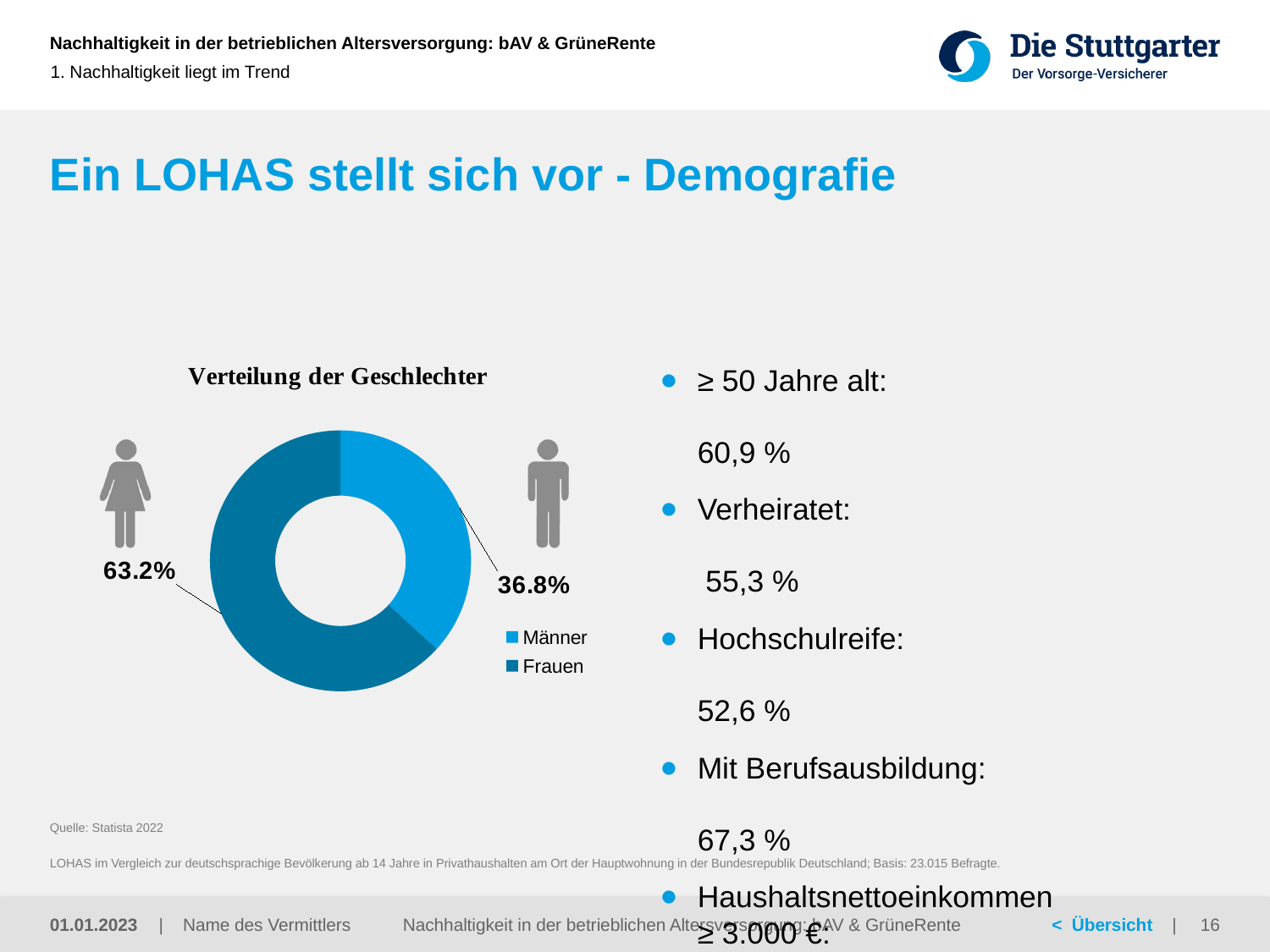
What kind of chart is shown under the title "Verteilung der Geschlechter"? doughnut chart In the chart "Verteilung der Geschlechter", by how many percentage points does the share for Frauen exceed the share for Männer? 26.4 percentage points What are the two legend entries of the chart "Verteilung der Geschlechter"? Männer and Frauen Which category has the smallest slice in the chart "Verteilung der Geschlechter"? Männer How many categories are shown in the chart "Verteilung der Geschlechter"? 2 In the chart "Verteilung der Geschlechter", what share is shown for Männer? 36.8% In the chart "Verteilung der Geschlechter", what share is shown for Frauen? 63.2% In the chart "Verteilung der Geschlechter", what do the shares for Männer and Frauen add up to? 100% How many entries does the legend of the chart "Verteilung der Geschlechter" list? 2 Which category has the largest slice in the chart "Verteilung der Geschlechter"? Frauen What is the title of the chart on the slide? Verteilung der Geschlechter In the chart "Verteilung der Geschlechter", which is larger, the share for Männer or the share for Frauen? Frauen